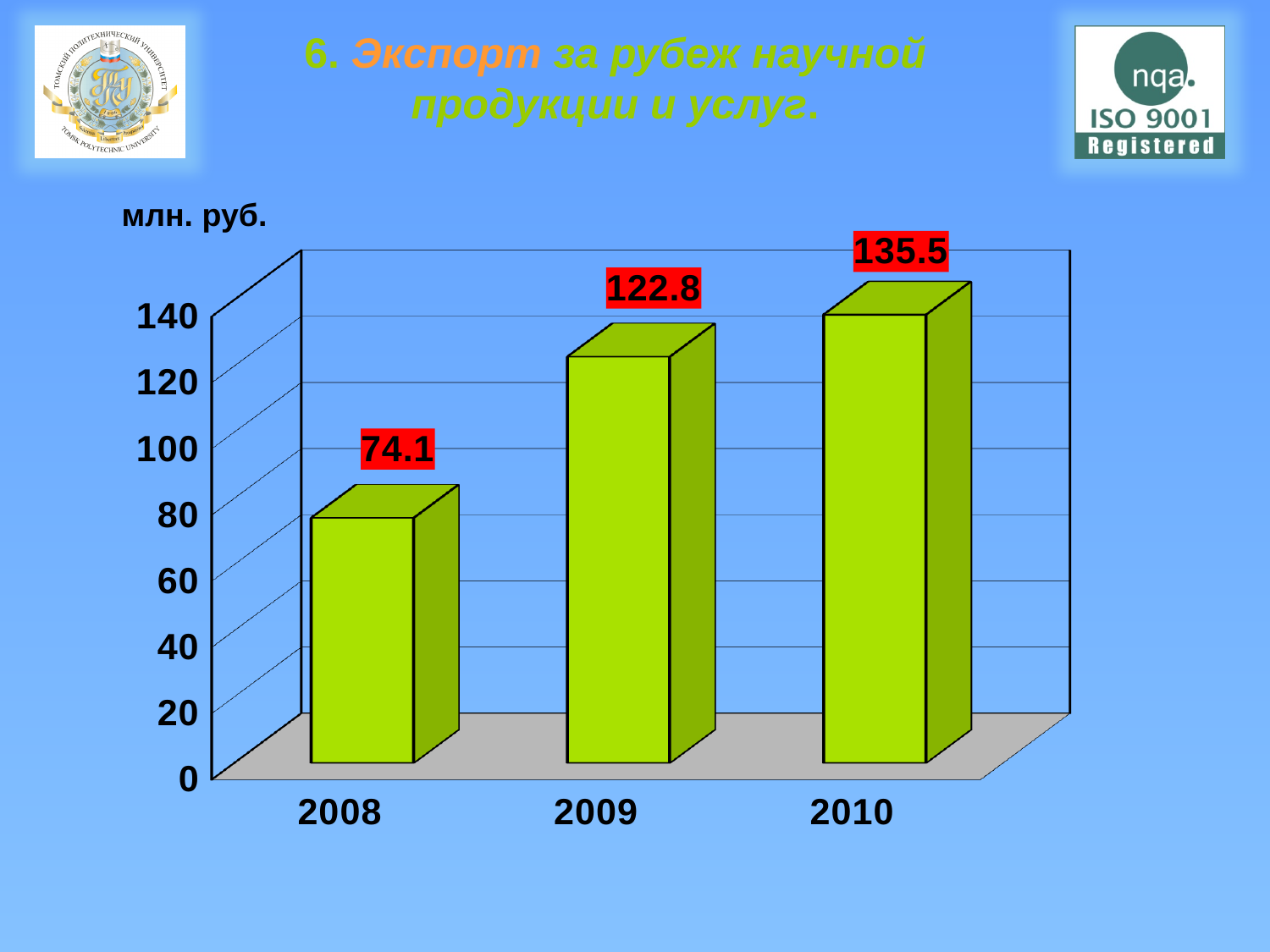
What is the value for 2009? 122.8 What is the difference between the values for 2009 and 2008? 48.7 How many years are shown on the chart? 3 What kind of chart is shown on the slide? bar chart What is the difference between the values for 2010 and 2008? 61.4 Is the value for 2008 greater or less than 80? less What is the value for 2008? 74.1 Do the values rise or fall from 2008 to 2010? rise Which is larger, the value for 2009 or the value for 2010? 2010 What is the value for 2010? 135.5 Which year has the highest value? 2010 Which year has the lowest value? 2008